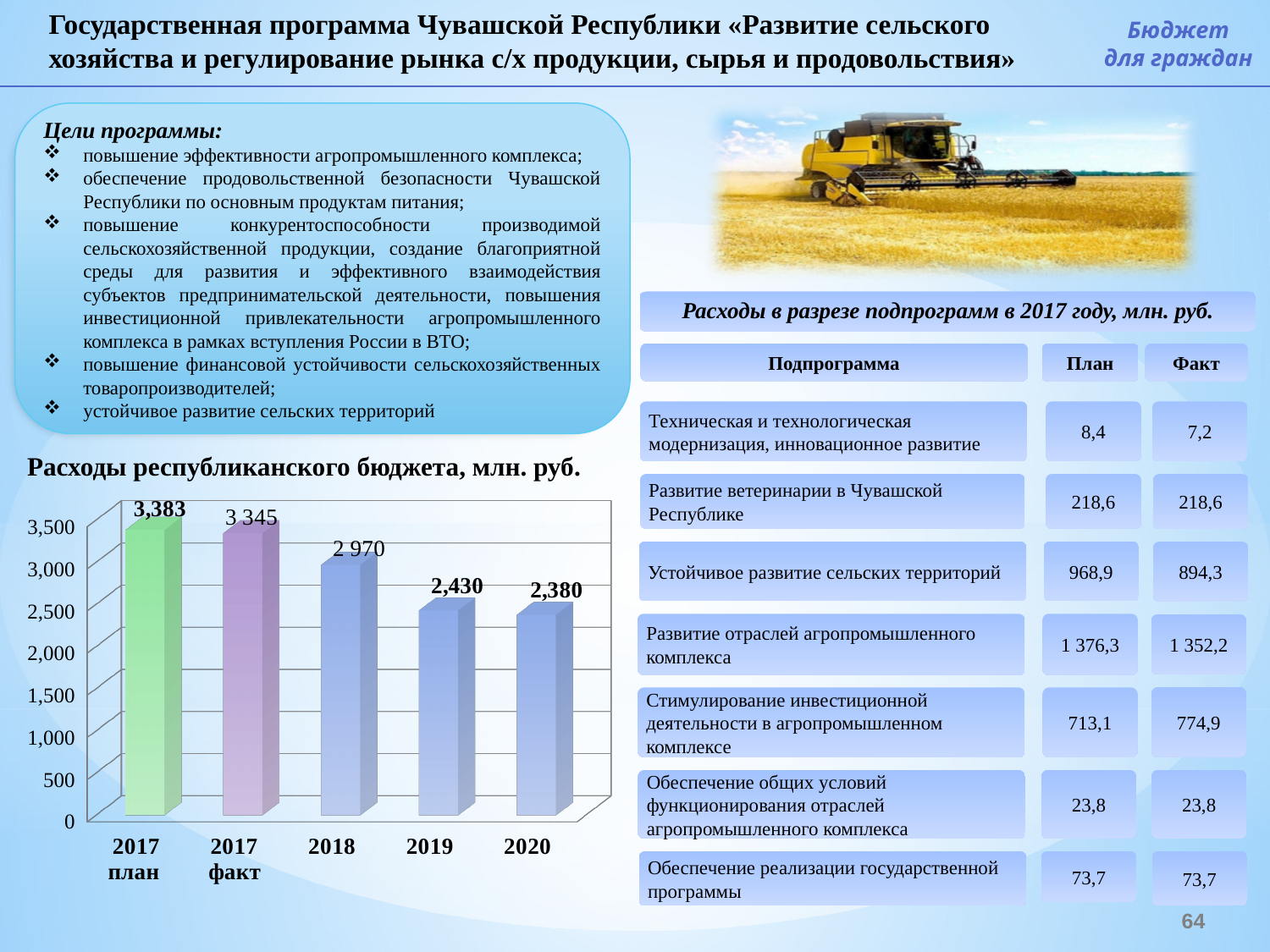
What is the value for 2017 план in the chart 'Расходы республиканского бюджета, млн. руб.'? 3,383 What is the difference between the 2019 and 2020 values in the chart 'Расходы республиканского бюджета, млн. руб.'? 50 Which category has the highest value in the chart 'Расходы республиканского бюджета, млн. руб.'? 2017 план Which category has the lowest value in the chart 'Расходы республиканского бюджета, млн. руб.'? 2020 What is the value for 2018 in the chart 'Расходы республиканского бюджета, млн. руб.'? 2 970 How many bars are shown in the chart 'Расходы республиканского бюджета, млн. руб.'? 5 Do the values in the chart 'Расходы республиканского бюджета, млн. руб.' rise or fall from 2018 to 2020? fall What is the value for 2020 in the chart 'Расходы республиканского бюджета, млн. руб.'? 2,380 What kind of chart is 'Расходы республиканского бюджета, млн. руб.'? bar chart Which is larger in the chart 'Расходы республиканского бюджета, млн. руб.': the value for 2018 or the value for 2019? 2018 What is the difference between the 2017 план and 2018 values in the chart 'Расходы республиканского бюджета, млн. руб.'? 413 What is the value for 2017 факт in the chart 'Расходы республиканского бюджета, млн. руб.'? 3 345